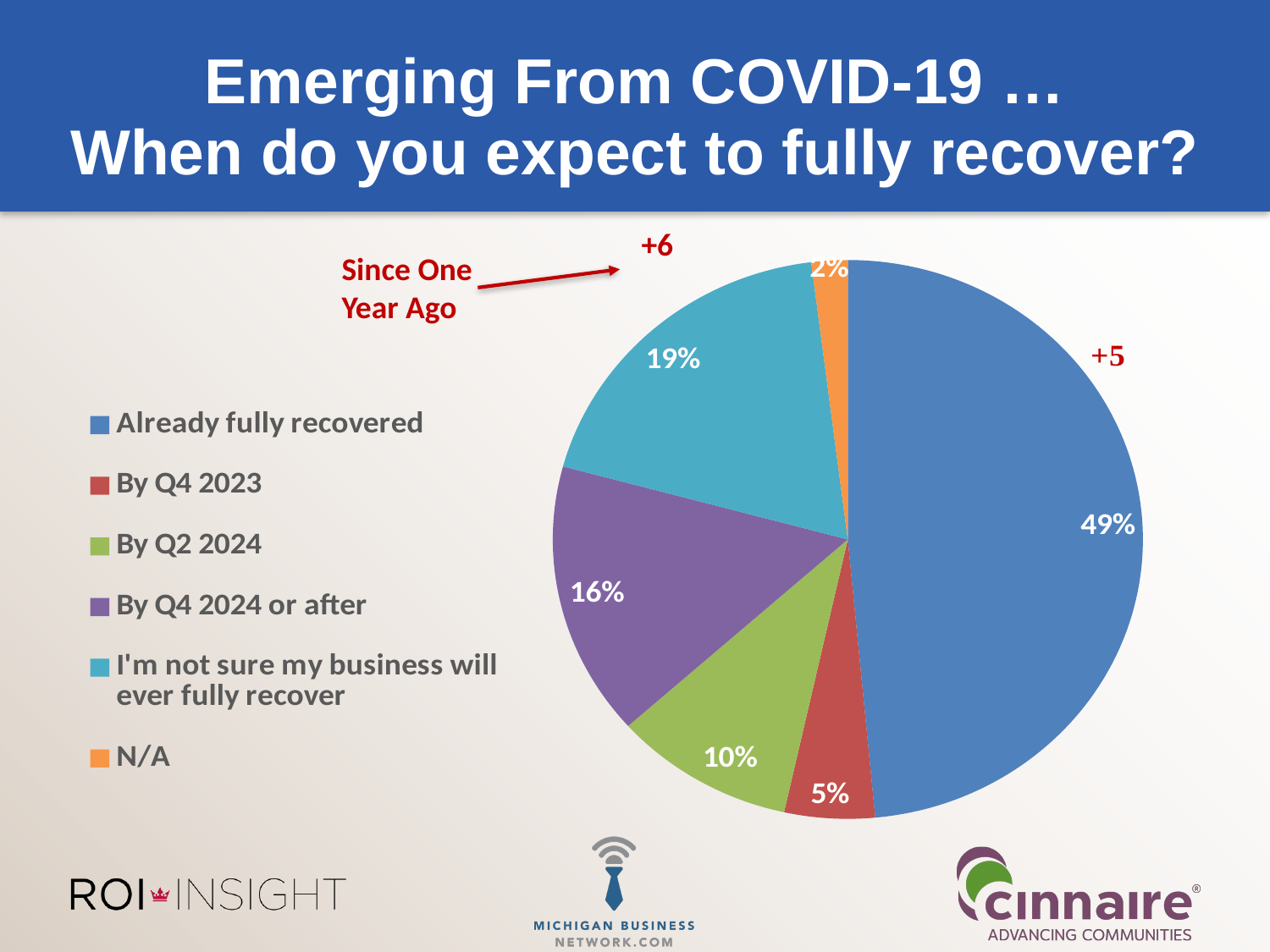
What share of the pie is 'I'm not sure my business will ever fully recover'? 19% What share of the pie is 'By Q4 2023'? 5% Which is larger: the slice for 'By Q4 2024 or after' or the slice for 'By Q2 2024'? By Q4 2024 or after What share of the pie is 'By Q2 2024'? 10% What kind of chart is shown on the slide? Pie chart How many categories does the legend list? 6 What share of the pie is 'N/A'? 2% Which category has the smallest slice of the pie? N/A What is the difference in percentage points between 'Already fully recovered' and 'I'm not sure my business will ever fully recover'? 30 What share of the pie is 'By Q4 2024 or after'? 16% Which category has the largest slice of the pie? Already fully recovered What share of the pie is 'Already fully recovered'? 49%